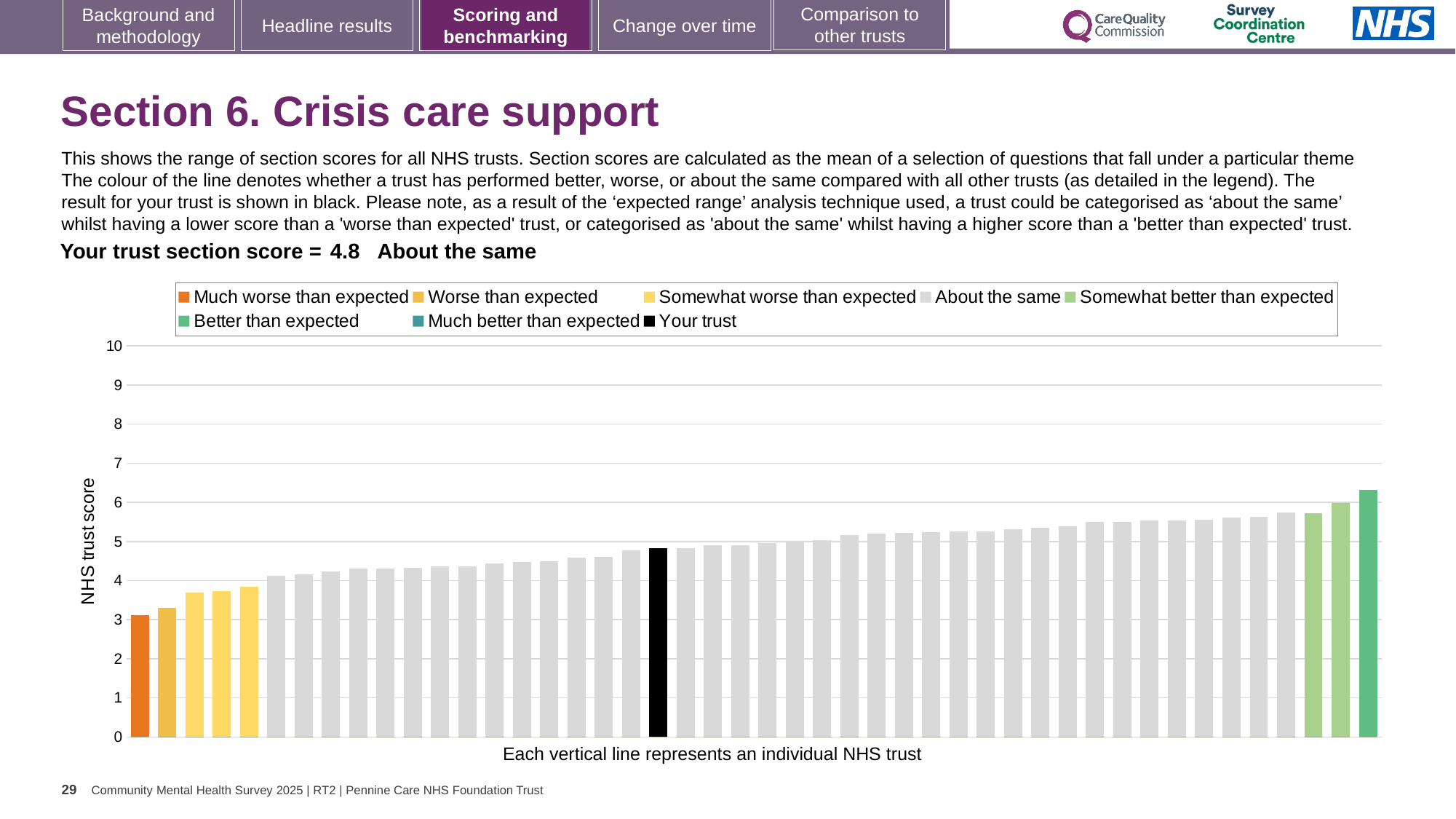
Which is larger: the value for 'Your trust' or the value for the 'Better than expected' trust? Better than expected Is the value for the shortest bar (the 'Much worse than expected' trust) greater or less than 4? less How many bars are coloured as 'Somewhat worse than expected'? 3 Is the value for the black 'Your trust' bar greater or less than 5? less How many entries does the legend list? 8 How many bars are coloured as 'Somewhat better than expected'? 2 What kind of chart is shown on the slide? bar chart Do the bar values rise or fall from left to right along the x axis? rise Which legend category does the lowest bar on the chart belong to? Much worse than expected Is the value for the tallest bar (the 'Better than expected' trust) greater or less than 6? greater What colour is used for the 'Your trust' bar? black What is the section score for your trust shown on the slide? 4.8